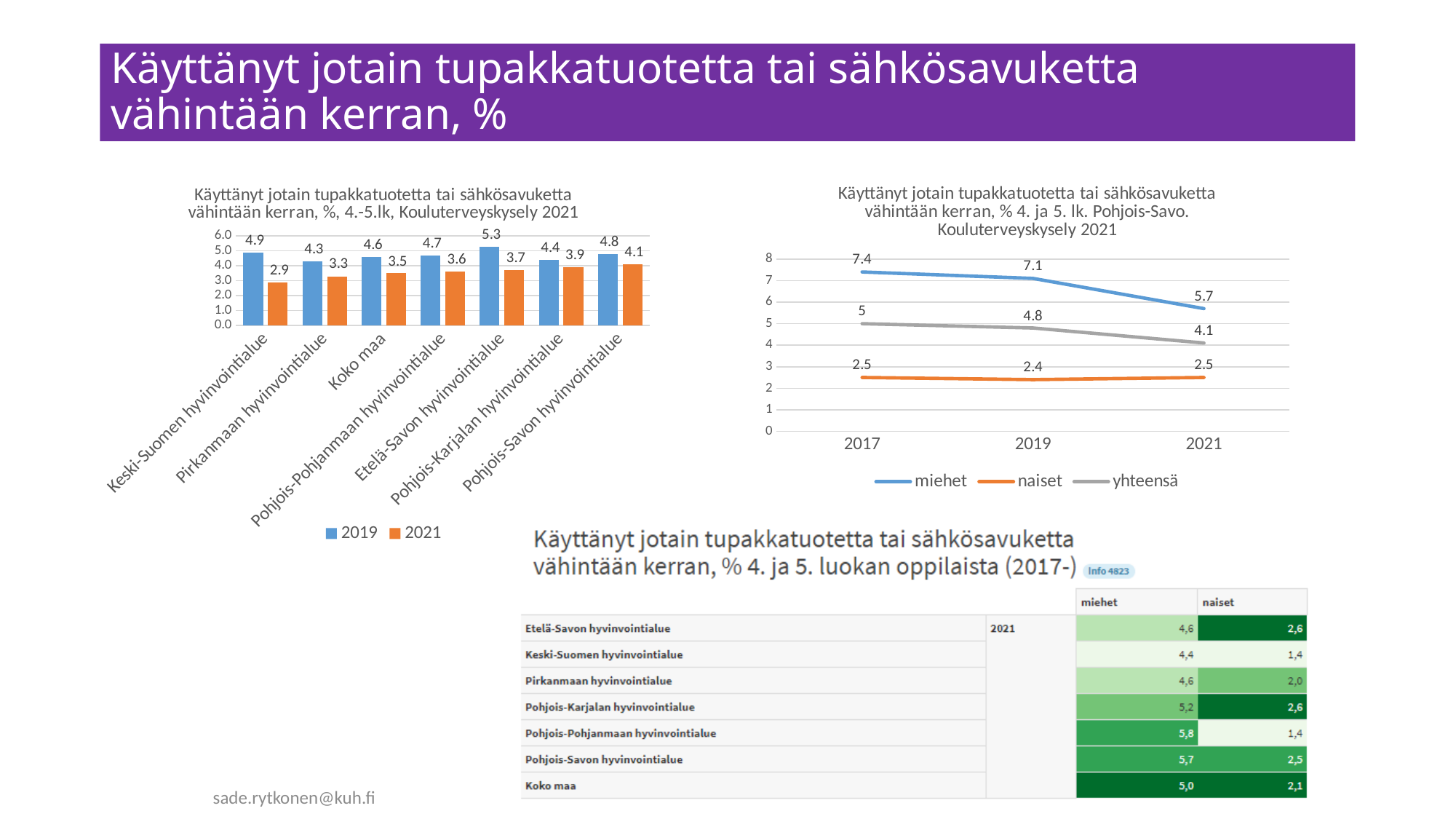
In the bar chart on the left, which category has the highest 2019 value? Etelä-Savon hyvinvointialue In the line chart on the right, what is the value for miehet in 2021? 5.7 In the bar chart on the left, how many series does the legend list? 2 In the line chart on the right, what is the value for yhteensä in 2019? 4.8 In the bar chart on the left, which category has the lowest 2021 value? Keski-Suomen hyvinvointialue In the bar chart on the left, how many categories are shown on the x axis? 7 In the line chart on the right, does the miehet line rise or fall from 2017 to 2021? fall In the line chart on the right, which is larger in 2017: miehet or naiset? miehet What kind of chart is the chart on the right of the slide? line chart In the bar chart on the left, what is the 2021 value for Pohjois-Savon hyvinvointialue? 4.1 In the bar chart on the left, what is the difference between the 2019 and 2021 values for Keski-Suomen hyvinvointialue? 2.0 In the bar chart on the left, what is the 2019 value for Etelä-Savon hyvinvointialue? 5.3